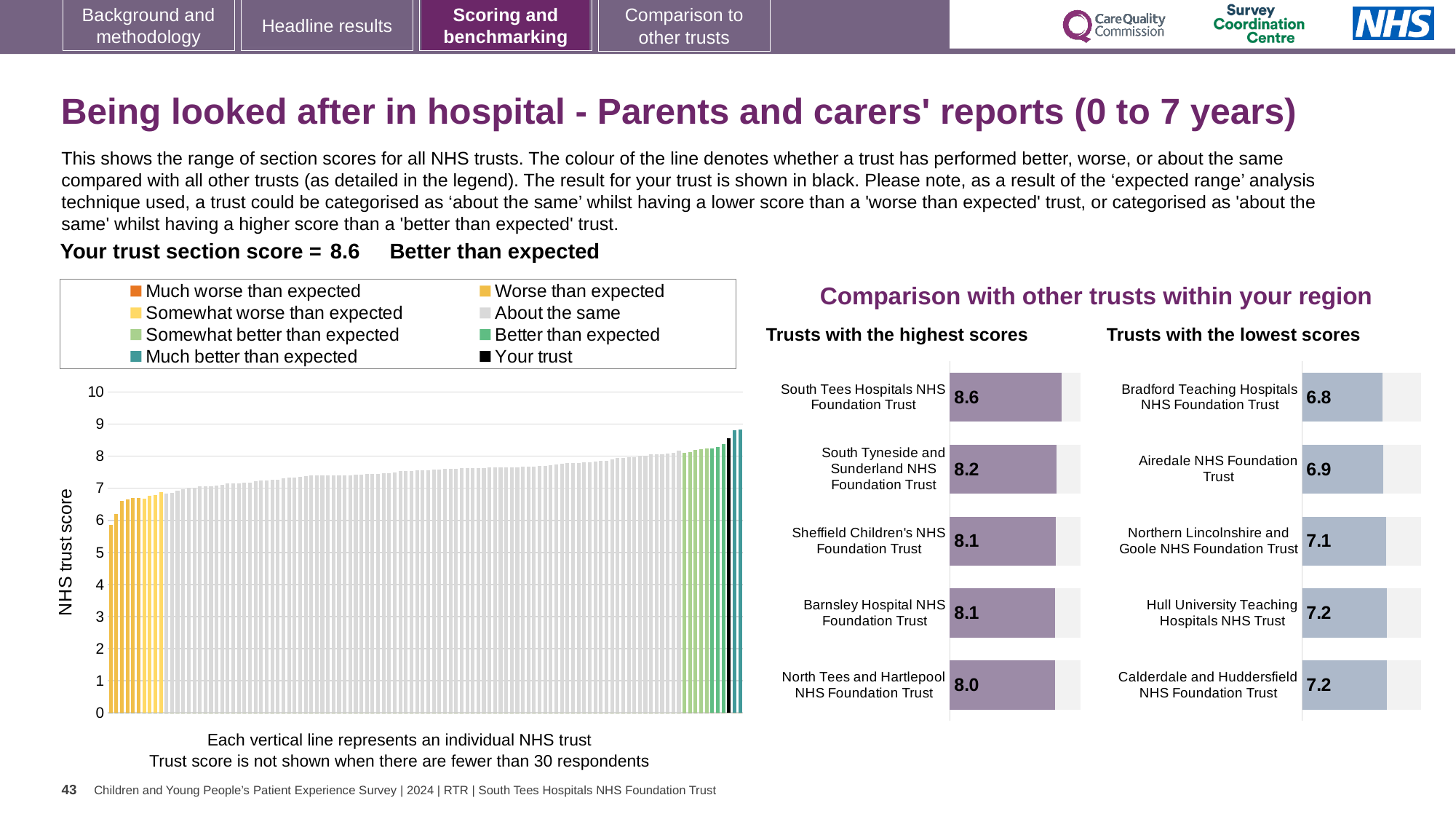
How many entries does the legend above the large chart on the left list? 8 In the 'Trusts with the highest scores' chart, which trust has the highest score? South Tees Hospitals NHS Foundation Trust In the large chart on the left, is the value of the black bar for your trust greater or less than 8? greater In the 'Trusts with the lowest scores' chart, what is the score for Bradford Teaching Hospitals NHS Foundation Trust? 6.8 In the 'Trusts with the lowest scores' chart, which trust has the lowest score? Bradford Teaching Hospitals NHS Foundation Trust In the 'Trusts with the highest scores' chart, what is the score for South Tees Hospitals NHS Foundation Trust? 8.6 How many trusts are shown in the 'Trusts with the highest scores' chart? 5 In the 'Trusts with the lowest scores' chart, which has the larger score: Airedale NHS Foundation Trust or Hull University Teaching Hospitals NHS Trust? Hull University Teaching Hospitals NHS Trust In the 'Trusts with the highest scores' chart, what is the difference between the scores of South Tees Hospitals NHS Foundation Trust and North Tees and Hartlepool NHS Foundation Trust? 0.6 In the 'Trusts with the lowest scores' chart, what is the difference between the scores of Calderdale and Huddersfield NHS Foundation Trust and Bradford Teaching Hospitals NHS Foundation Trust? 0.4 In the large chart on the left, do the trust scores rise or fall from left to right? Rise What kind of chart is the large chart on the left showing NHS trust scores? Bar chart